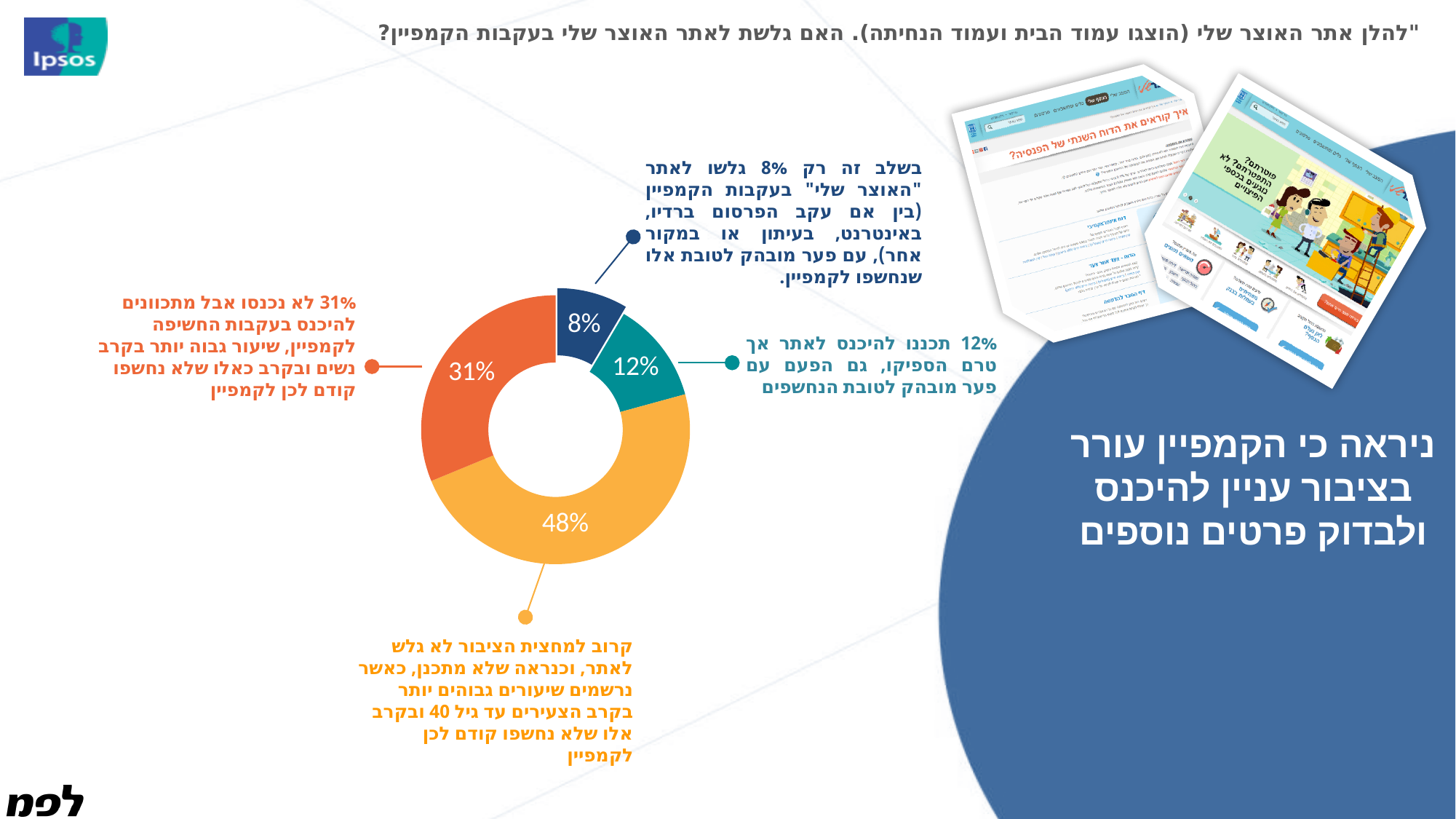
What is the difference between the largest slice (48%) and the slice for those who did not visit but intend to (31%)? 17 percentage points What is the combined share of the 8% and 12% slices? 20% What percentage of respondents visited the 'האוצר שלי' site following the campaign (the dark blue slice)? 8% What colour is the slice representing 31%? Red-orange What is the value of the smallest slice in the donut chart? 8% What is the value of the largest slice in the donut chart? 48% What percentage planned to visit the site but had not yet done so (the teal slice)? 12% Which is larger: the teal slice or the dark blue slice? The teal slice (12%) What kind of chart is shown on the slide? Pie chart (donut) What is the value of the yellow-orange slice in the donut chart? 48% How many slices does the donut chart have? 4 What percentage did not visit the site but intend to (the red-orange slice)? 31%